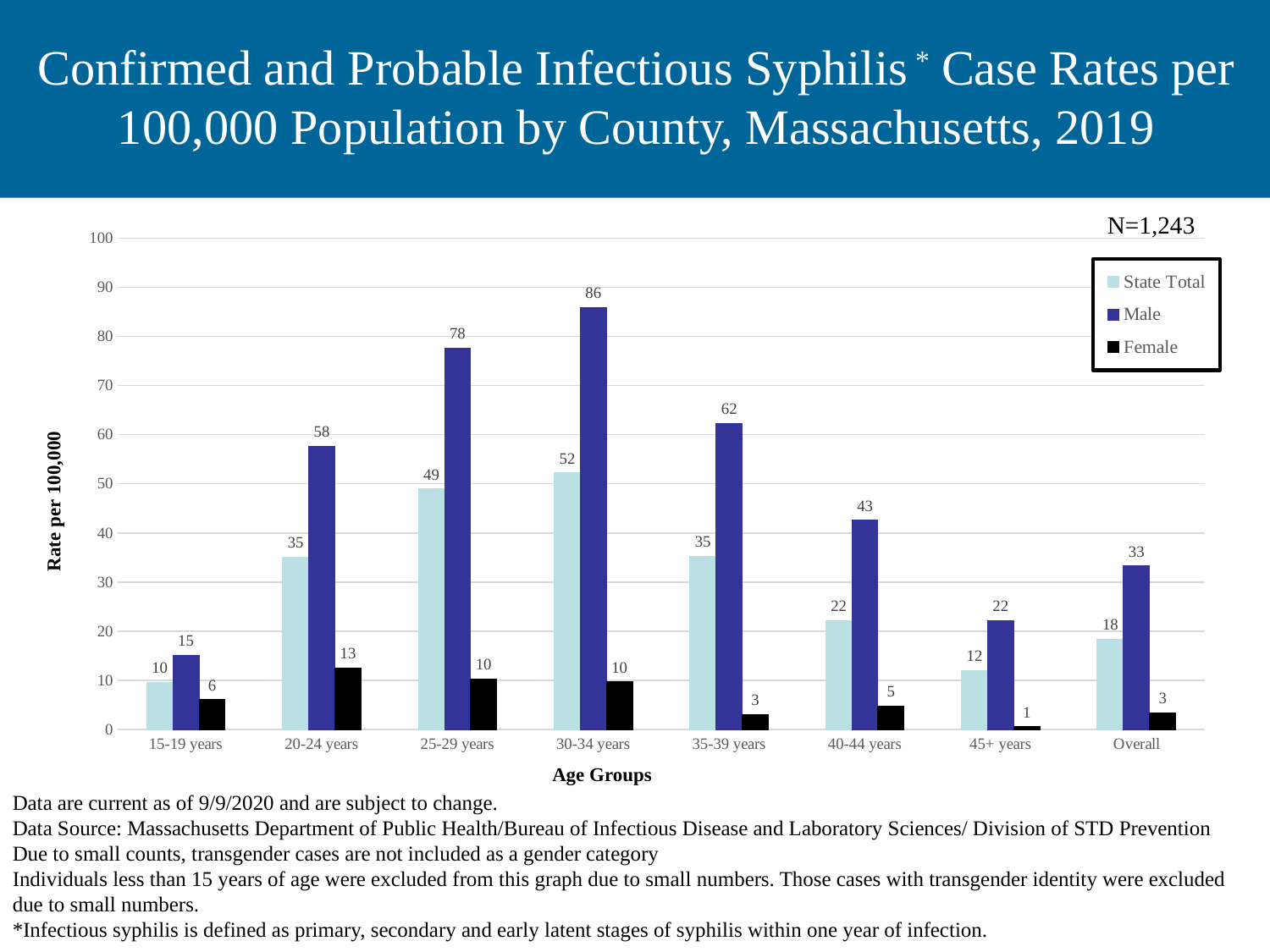
Which age group has the lowest Female rate? 45+ years What is the Male rate for the 30-34 years age group? 86 How many age group categories are shown on the x axis, including Overall? 8 What is the difference between the Male and Female rates for the 25-29 years age group? 68 What is the N value shown above the chart? N=1,243 How many series does the legend list? 3 What is the State Total rate for the Overall category? 18 Which is larger, the State Total rate for 20-24 years or for 40-44 years? 20-24 years What kind of chart is shown on the slide? bar chart What is the Female rate for the 20-24 years age group? 13 Which age group has the highest Male rate? 30-34 years Is the Male rate for the 35-39 years age group greater or less than 60? greater